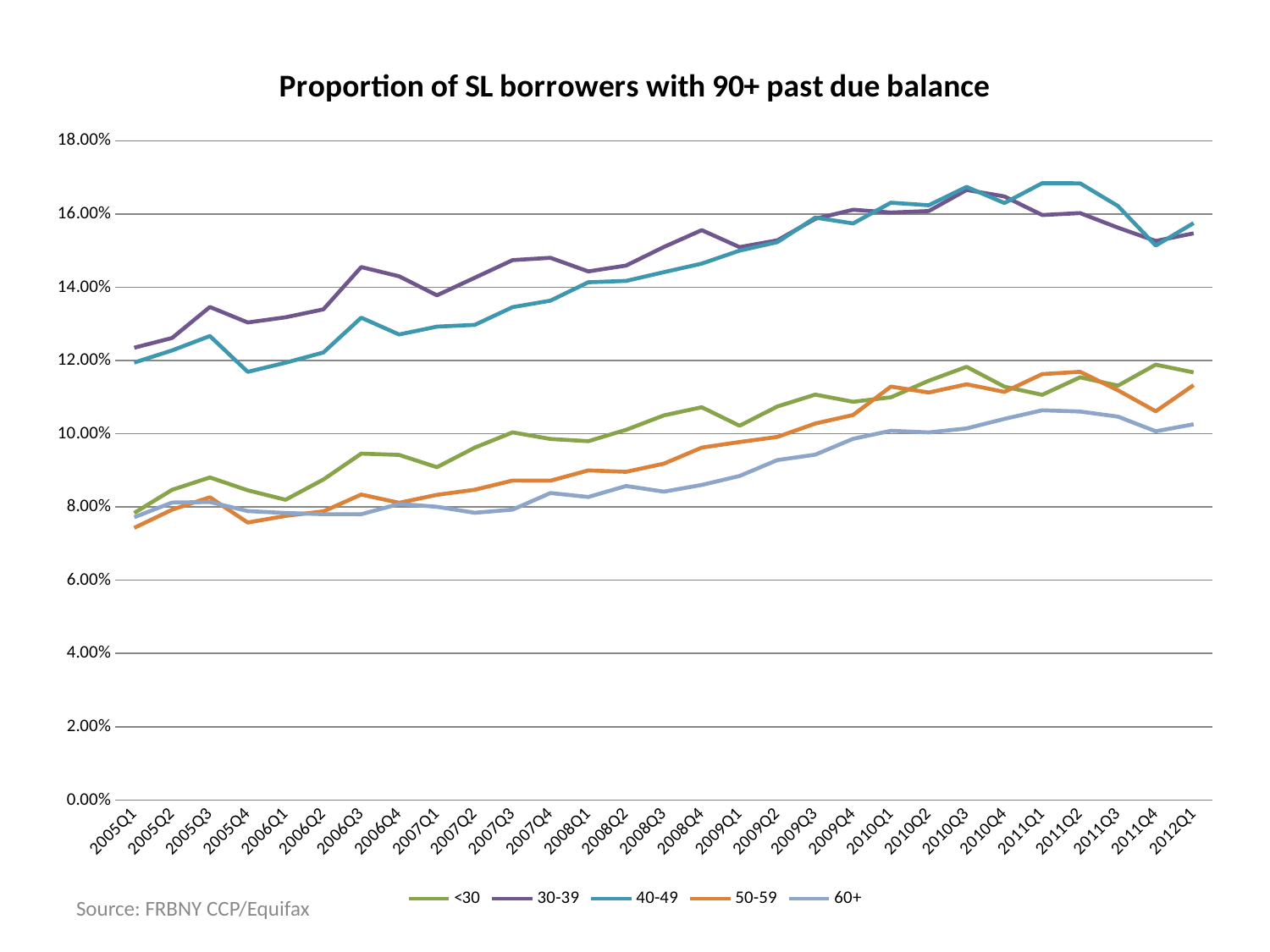
Is the value for the 40-49 series at 2010Q3 greater or less than 16.00%? greater What is the title of the chart? Proportion of SL borrowers with 90+ past due balance How many series does the legend list? 5 Is the value for the 60+ series at 2005Q1 greater or less than 8.00%? less Which series has the lowest value at 2012Q1? 60+ What kind of chart is shown on the slide? line chart Does the 60+ series generally rise or fall from 2005Q1 to 2012Q1? rise At 2011Q1, which series has the larger value, 40-49 or 30-39? 40-49 What source is cited for the chart? FRBNY CCP/Equifax How many quarters are plotted along the x axis? 29 Is the value for the 30-39 series at 2005Q1 greater or less than 12.00%? greater